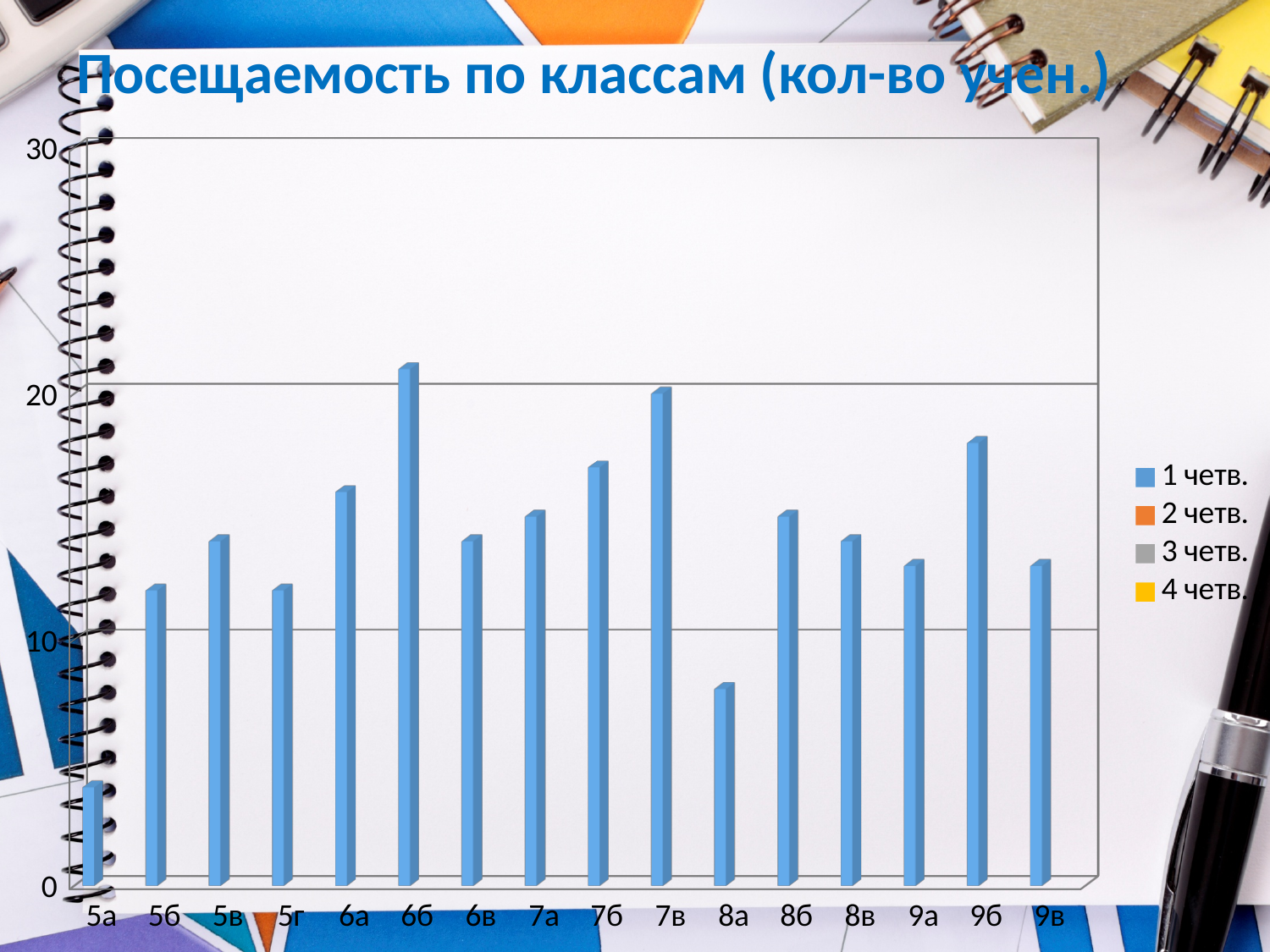
Is the value for 7б greater or less than 10? greater Is the value for 8а greater or less than 10? less How many series does the legend list? 4 Is the value for 9б greater or less than 20? less Which class has the lowest bar? 5а Which class has the larger value, 9б or 9а? 9б How many classes (categories) are shown on the x axis? 16 What kind of chart is shown on the slide? bar chart What is the title of the chart? Посещаемость по классам (кол-во учен.) Which legend entry is shown in blue? 1 четв. Which class has the highest bar? 6б